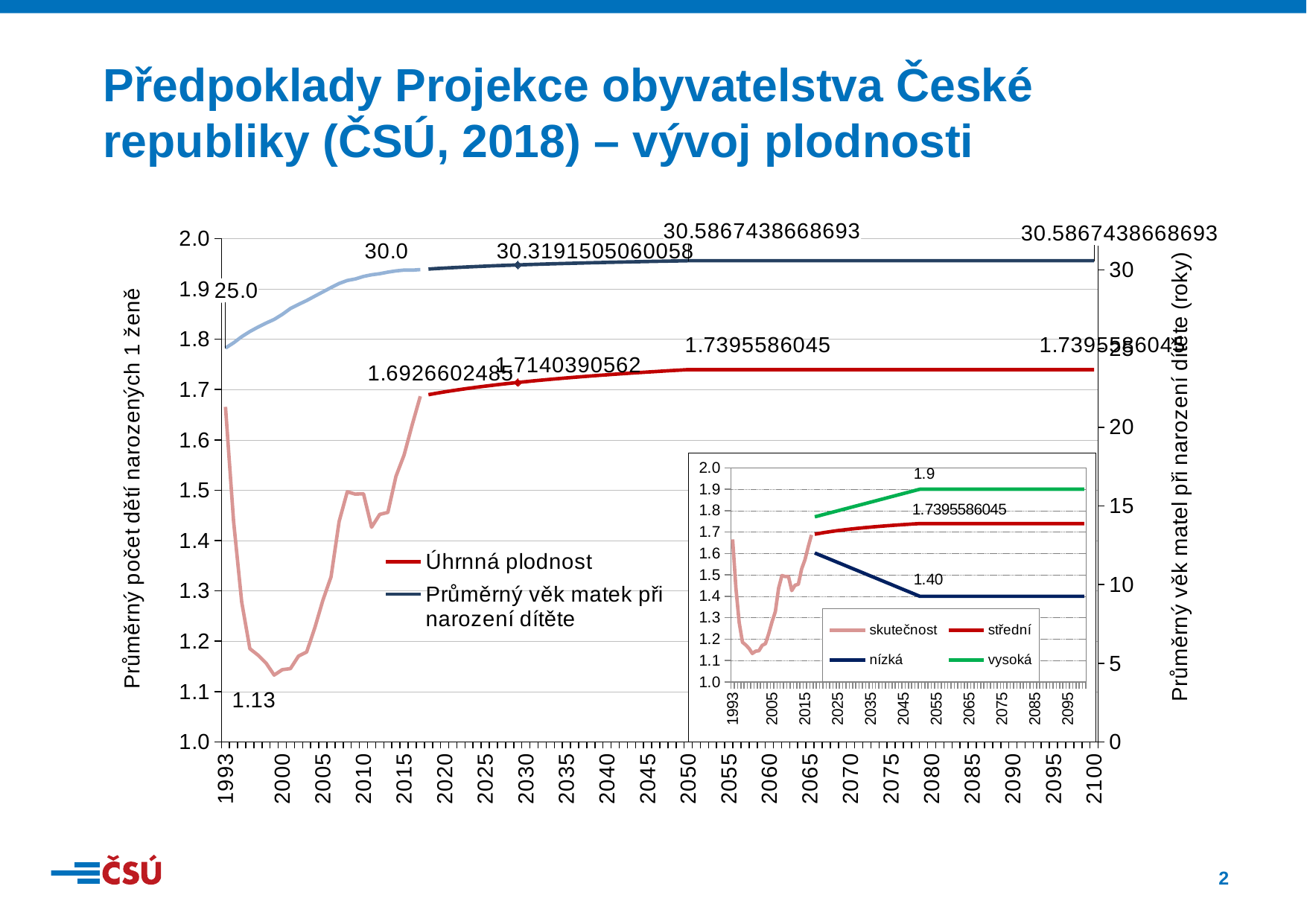
In the main chart, what is the lowest labelled value of the Úhrnná plodnost series? 1.13 In the main chart, what value is labelled for Průměrný věk matek při narození dítěte at 2100? 30.5867438668693 How many series does the legend of the main chart list? 2 In the main chart, what value is labelled for Úhrnná plodnost around 2030? 1.7140390562 In the main chart, what value is labelled for Průměrný věk matek při narození dítěte at the start of the series in 1993? 25.0 In the inset chart, which series ends at the highest value: nízká, střední or vysoká? vysoká How many series does the legend of the inset chart list? 4 In the main chart, what value is labelled for Úhrnná plodnost at the end of the projection (2100)? 1.7395586045 In the main chart, does the Průměrný věk matek při narození dítěte series rise or fall between 1993 and 2015? rise What type of chart is the main chart on the slide? line chart In the inset chart, what value is labelled for the nízká series? 1.40 In the inset chart, what value is labelled for the vysoká series? 1.9